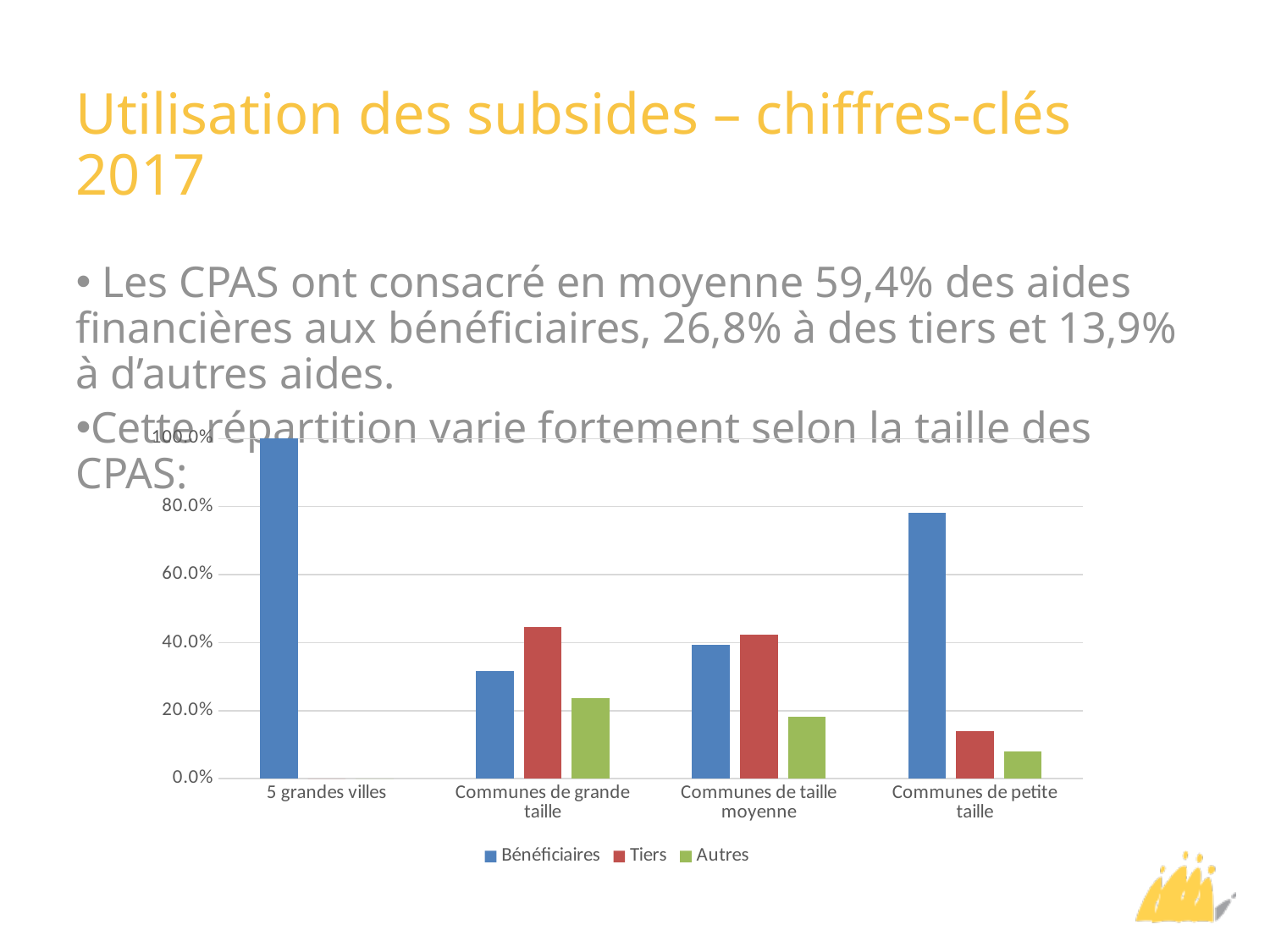
What kind of chart is shown on the slide? bar chart What is the value for Bénéficiaires in the 5 grandes villes category? 100.0% Which colour represents the Tiers series in the chart? red Is the value for Tiers in Communes de grande taille greater or less than 40.0%? greater Is the value for Bénéficiaires in Communes de petite taille greater or less than 60.0%? greater Is the value for Bénéficiaires in Communes de grande taille greater or less than 40.0%? less How many series does the chart legend list? 3 In the Communes de grande taille category, which is larger: Bénéficiaires or Tiers? Tiers Which category has the highest value for Bénéficiaires? 5 grandes villes How many categories are shown on the x axis of the chart? 4 Which category has the lowest value for Bénéficiaires? Communes de grande taille